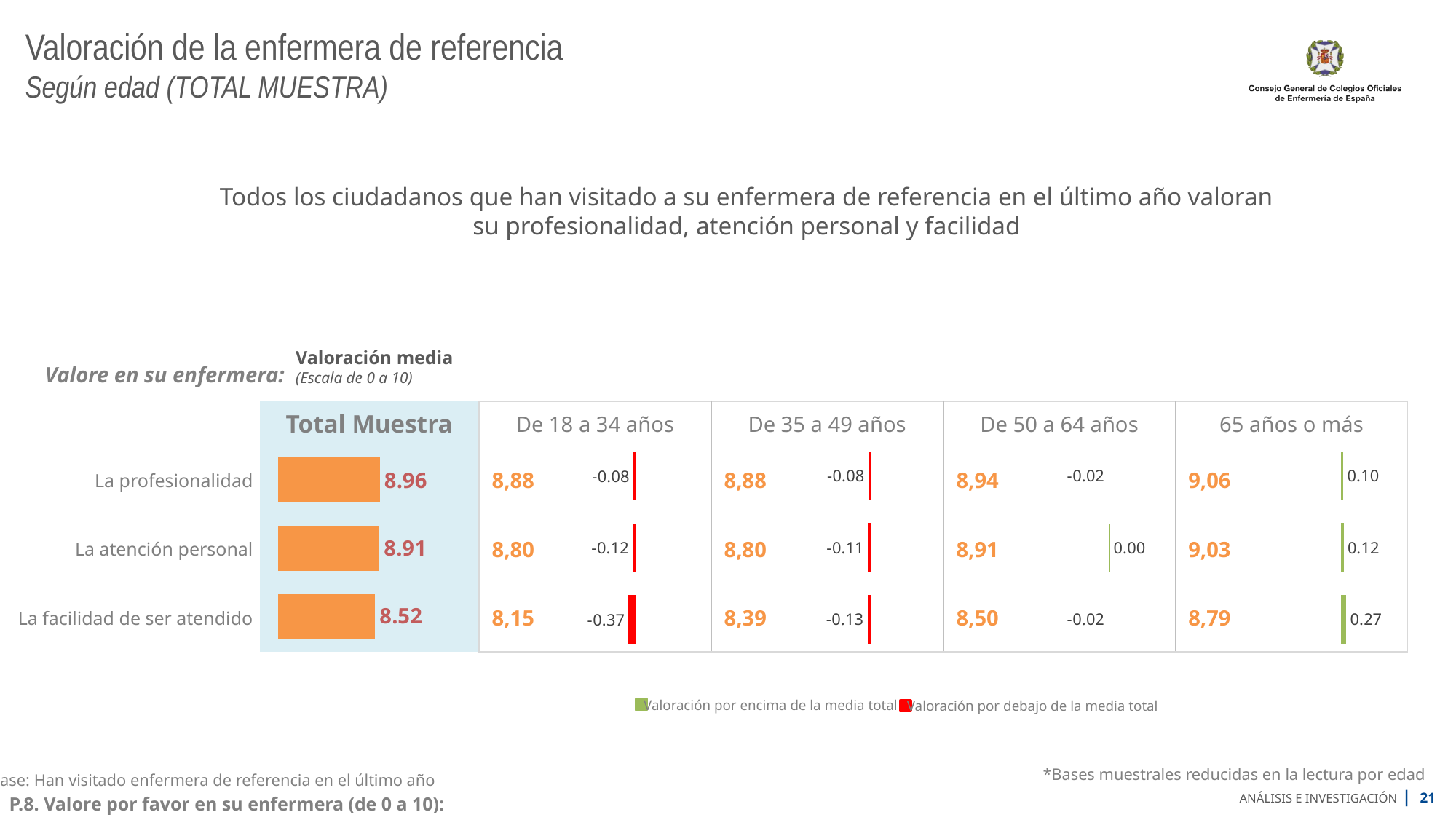
In the Total Muestra bar chart, which category has the lowest value? La facilidad de ser atendido In the Total Muestra bar chart, what is the value for La facilidad de ser atendido? 8.52 What is the deviation from the total mean shown for La facilidad de ser atendido in the De 18 a 34 años group? -0.37 What is the value for La facilidad de ser atendido in the De 18 a 34 años group? 8,15 In the Total Muestra bar chart, what is the value for La profesionalidad? 8.96 In the Total Muestra bar chart, what is the difference between La profesionalidad and La facilidad de ser atendido? 0.44 According to the legend, what does the green colour indicate? Valoración por encima de la media total What is the value for La profesionalidad in the 65 años o más group? 9,06 In the Total Muestra bar chart, which category has the highest value? La profesionalidad In the Total Muestra bar chart, which is larger: La atención personal or La facilidad de ser atendido? La atención personal What kind of chart is used for the Total Muestra values? Bar chart How many categories are shown in the Total Muestra bar chart? 3